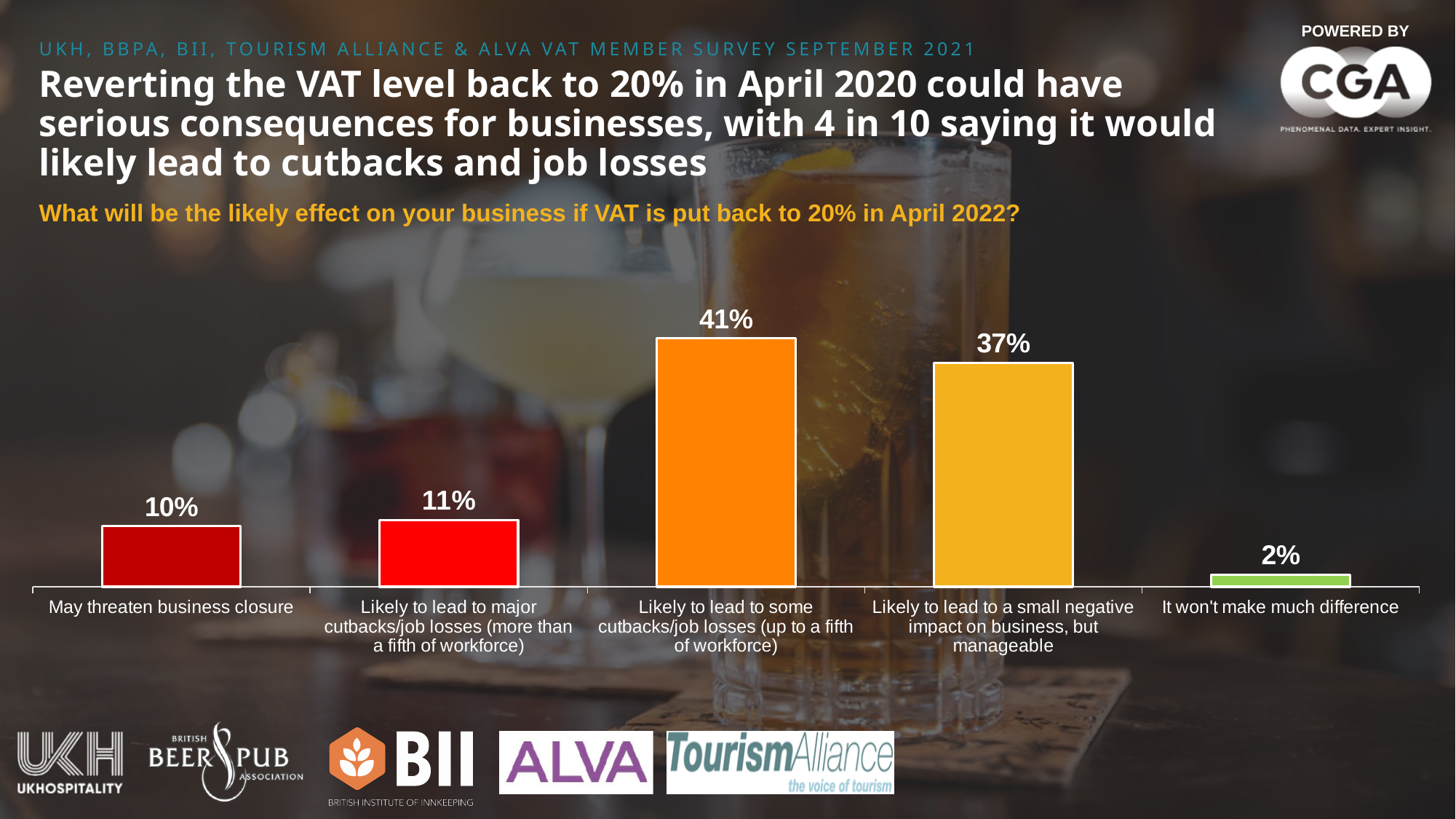
Which category has the highest value? Likely to lead to some cutbacks/job losses (up to a fifth of workforce) What is the value for 'Likely to lead to a small negative impact on business, but manageable'? 37% What is the value for 'Likely to lead to some cutbacks/job losses (up to a fifth of workforce)'? 41% What percentage of respondents said reverting VAT to 20% may threaten business closure? 10% What is the difference between the values for 'Likely to lead to some cutbacks/job losses' and 'Likely to lead to a small negative impact on business, but manageable'? 4% What is the combined value of 'May threaten business closure' and 'Likely to lead to major cutbacks/job losses (more than a fifth of workforce)'? 21% How many categories are shown in the chart? 5 Which category has the lowest value? It won't make much difference What kind of chart is shown on the slide? Bar chart What percentage said it won't make much difference? 2% Which is larger: the value for 'May threaten business closure' or 'Likely to lead to major cutbacks/job losses'? Likely to lead to major cutbacks/job losses What question does the chart present responses to? What will be the likely effect on your business if VAT is put back to 20% in April 2022?